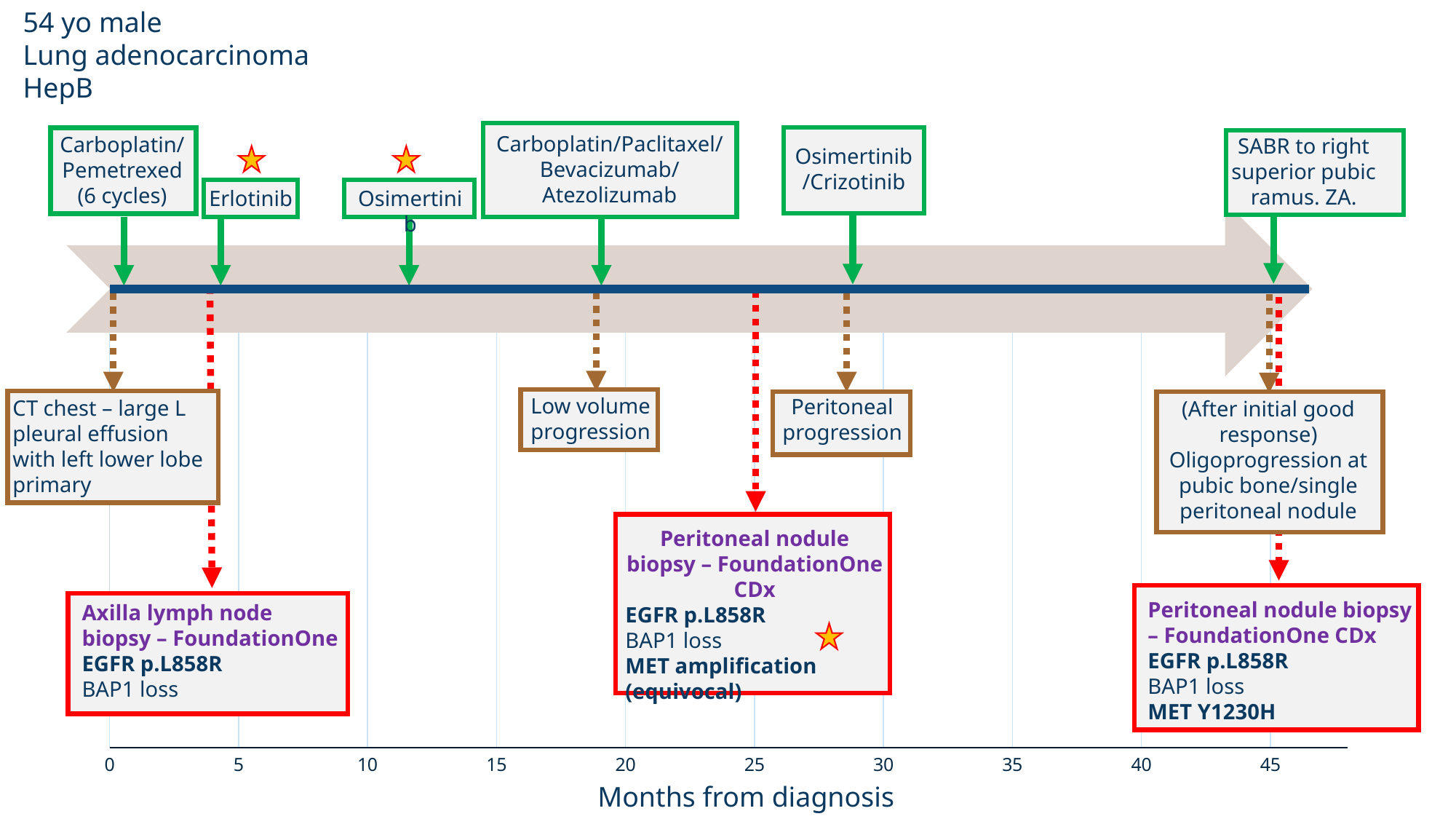
What is the title of the x axis on the timeline chart? Months from diagnosis What is the highest tick value shown on the months axis? 45 Is the start of Osimertinib/Crizotinib greater or less than 25 months from diagnosis? greater Which treatment occurs last on the timeline? SABR to right superior pubic ramus. ZA. Is the start of Carboplatin/Paclitaxel/Bevacizumab/Atezolizumab greater or less than 20 months from diagnosis? less Is the SABR to right superior pubic ramus event greater or less than 40 months from diagnosis? greater What kind of chart is shown on the slide? Timeline chart Which treatment occurs first on the timeline? Carboplatin/Pemetrexed (6 cycles) Which occurs later on the timeline: Low volume progression or Peritoneal progression? Peritoneal progression How many green treatment boxes are shown above the timeline? 6